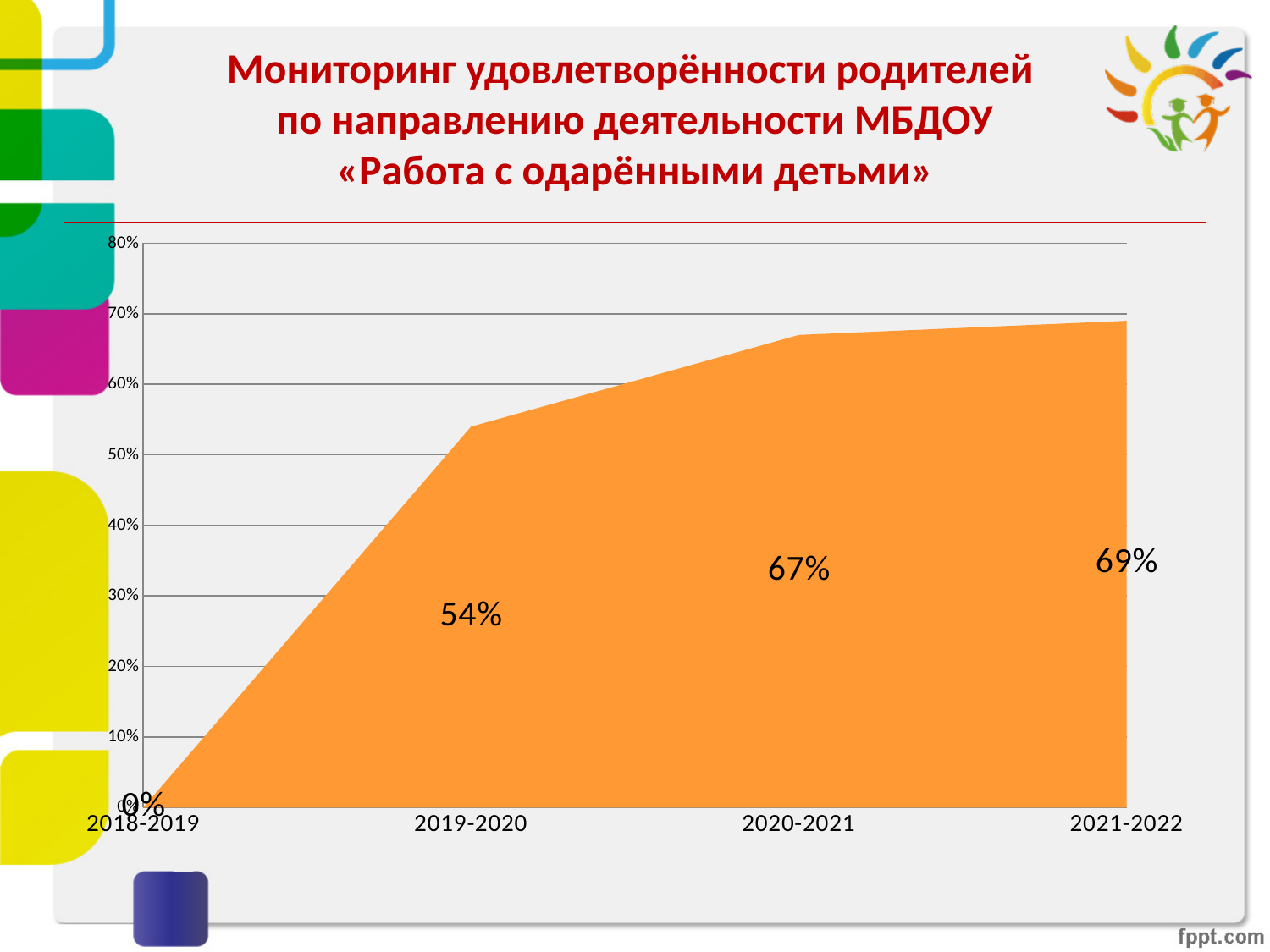
Do the values rise or fall from 2018-2019 to 2021-2022? rise What is the value for 2020-2021? 67% Which period has the highest value? 2021-2022 What is the value for 2021-2022? 69% Which is larger, the value for 2019-2020 or the value for 2020-2021? 2020-2021 How many periods are shown on the x axis? 4 What type of chart is shown on the slide? area chart What is the difference between the values for 2020-2021 and 2019-2020? 13% What is the difference between the values for 2021-2022 and 2020-2021? 2% What is the value for 2019-2020? 54% Which period has the lowest value? 2018-2019 What is the value for 2018-2019? 0%